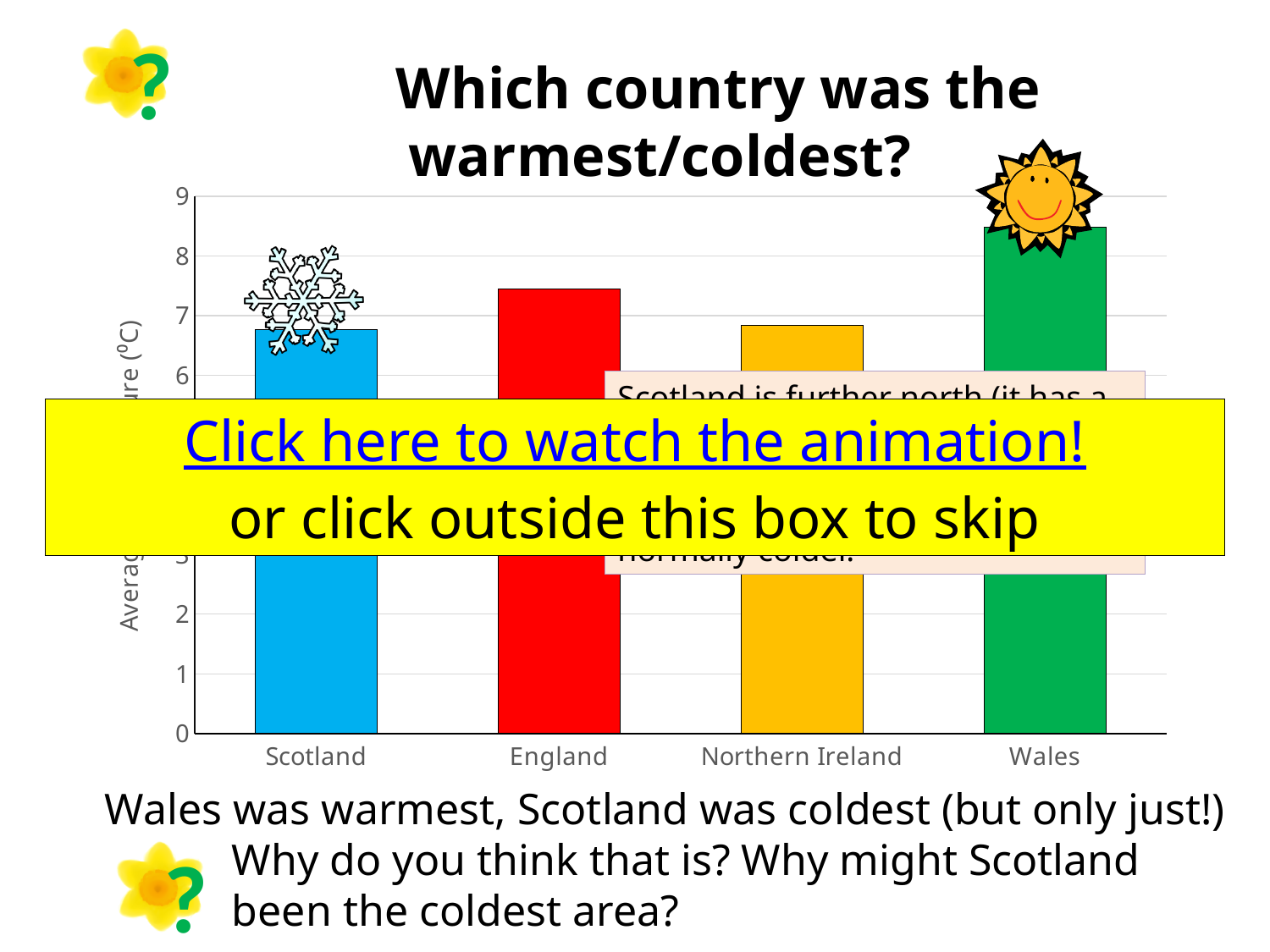
What colour is the bar for Wales? green What is the title of the chart? Which country was the warmest/coldest? Which has the larger value, Wales or England? Wales Which country has the highest bar on the chart? Wales Is the value for Wales greater or less than 8? greater Which has the larger value, England or Northern Ireland? England Is the value for Scotland greater or less than 7? less Is the value for Northern Ireland greater or less than 7? less How many countries are plotted on the chart? 4 Which has the larger value, England or Scotland? England What kind of chart is shown on the slide? bar chart